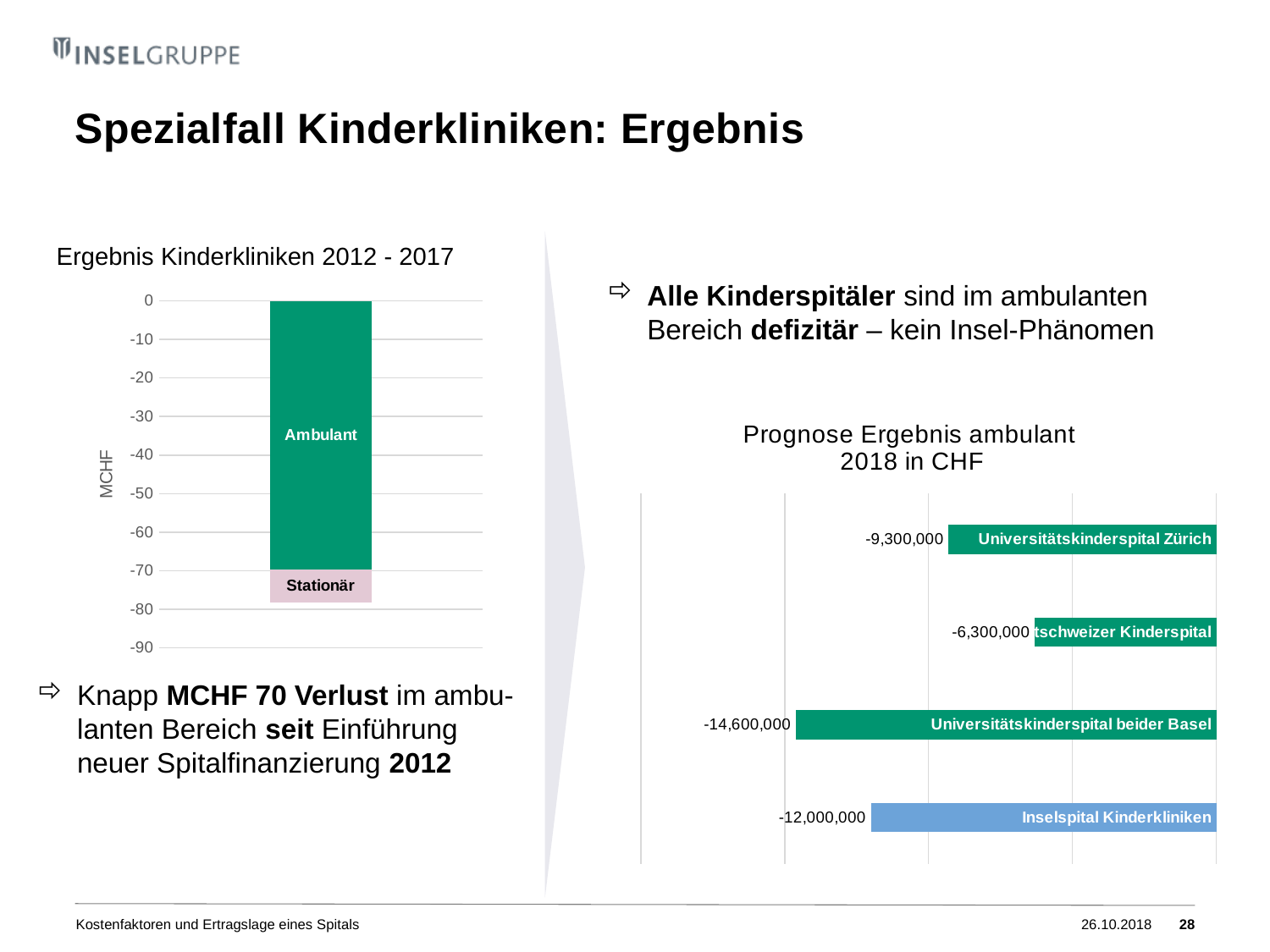
How many hospitals are shown in the chart 'Prognose Ergebnis ambulant 2018 in CHF'? 4 In the chart 'Prognose Ergebnis ambulant 2018 in CHF', which has the larger loss: Universitätskinderspital Zürich or Inselspital Kinderkliniken? Inselspital Kinderkliniken In the chart 'Prognose Ergebnis ambulant 2018 in CHF', which hospital has the smallest loss (least negative value)? Ostschweizer Kinderspital In the chart 'Prognose Ergebnis ambulant 2018 in CHF', how much larger is the loss of Universitätskinderspital beider Basel than that of Inselspital Kinderkliniken? 2,600,000 In the chart 'Prognose Ergebnis ambulant 2018 in CHF', what is the value for Universitätskinderspital beider Basel? -14,600,000 What kind of chart is 'Prognose Ergebnis ambulant 2018 in CHF'? Bar chart In the chart 'Prognose Ergebnis ambulant 2018 in CHF', what is the value for Inselspital Kinderkliniken? -12,000,000 What unit is shown on the vertical axis of the chart 'Ergebnis Kinderkliniken 2012 - 2017'? MCHF In the chart 'Ergebnis Kinderkliniken 2012 - 2017', which segment is larger in magnitude: Ambulant or Stationär? Ambulant In the chart 'Prognose Ergebnis ambulant 2018 in CHF', what is the value for Universitätskinderspital Zürich? -9,300,000 In the chart 'Ergebnis Kinderkliniken 2012 - 2017', is the value for Ambulant greater or less than -50 MCHF? less In the chart 'Prognose Ergebnis ambulant 2018 in CHF', which hospital has the largest loss (most negative value)? Universitätskinderspital beider Basel